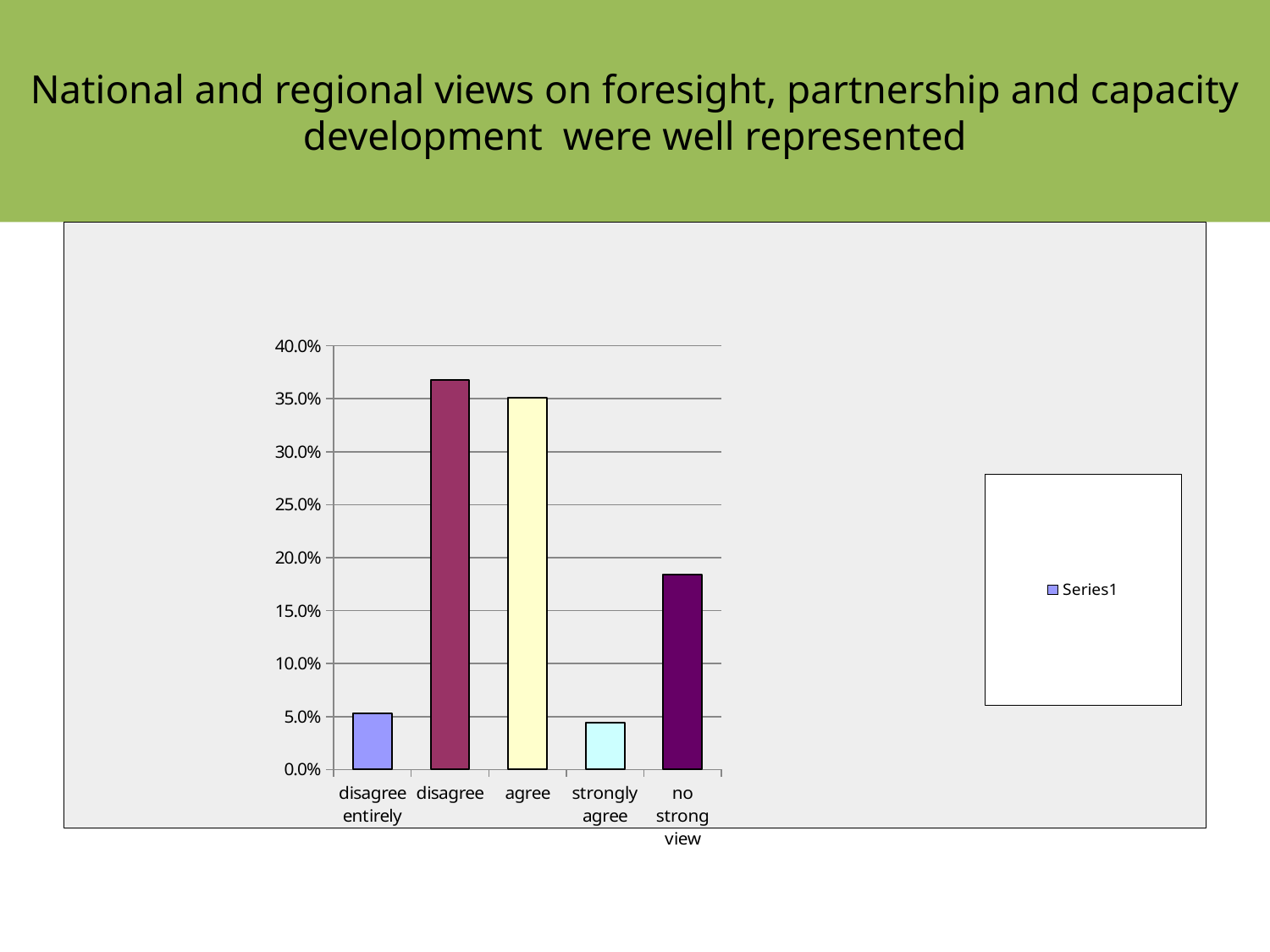
Is the value for 'no strong view' greater or less than 15%? greater How many series does the chart legend list? 1 Is the value for 'agree' greater or less than 30%? greater Is the value for 'disagree' greater or less than 30%? greater Which is larger, the value for 'no strong view' or the value for 'strongly agree'? no strong view How many categories are shown on the x axis of the chart? 5 Which category has the highest value in the chart? disagree What kind of chart is shown on the slide? bar chart What is the name of the series listed in the chart legend? Series1